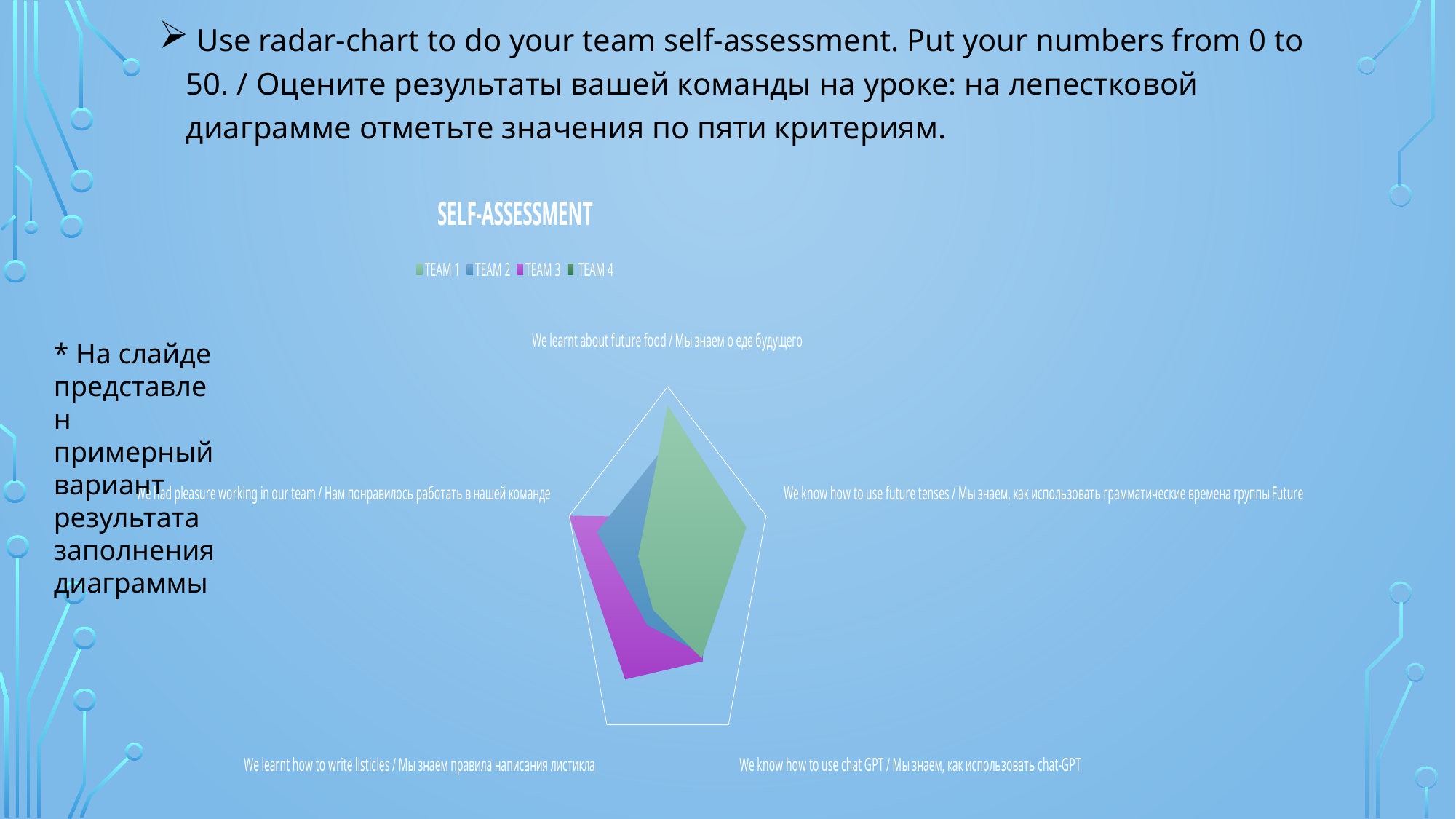
How many criteria (axes) does the radar chart have? 5 How many series does the chart legend list? 4 Which series is shown in magenta/purple in the chart? TEAM 3 On which criterion does TEAM 3 reach its highest value? We had pleasure working in our team On which criterion does TEAM 1 reach its highest value? We learnt about future food What is the title of the chart? SELF-ASSESSMENT For the criterion 'We learnt about future food', which team's value is the highest? TEAM 1 What kind of chart is shown on the slide? Radar chart